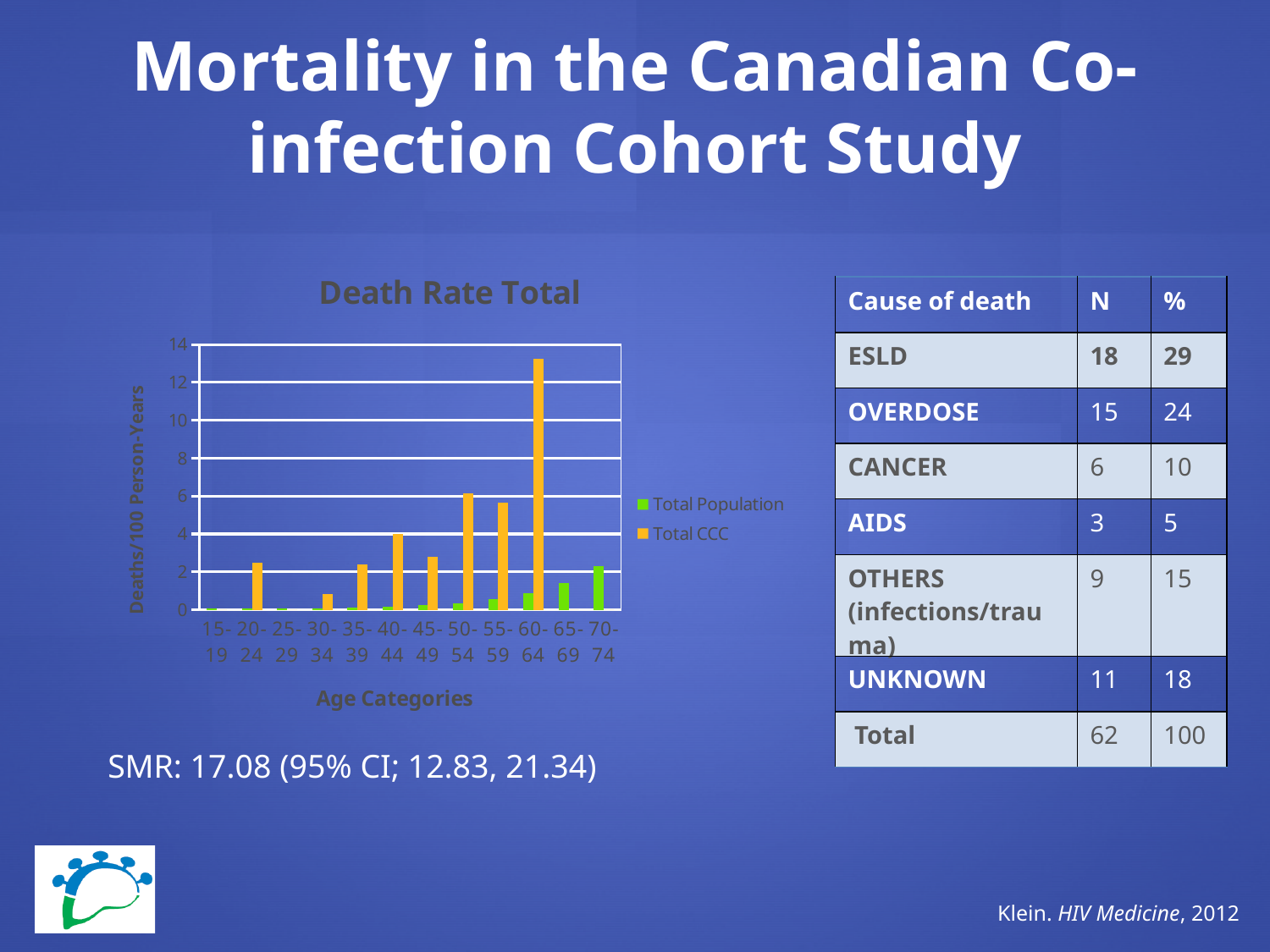
How many age categories are shown on the x axis of the "Death Rate Total" chart? 12 In the "Death Rate Total" chart, which is larger for the 60-64 age category: Total Population or Total CCC? Total CCC What is the y-axis title of the "Death Rate Total" chart? Deaths/100 Person-Years How many series does the legend of the "Death Rate Total" chart list? 2 In the "Death Rate Total" chart, is the Total Population value for 60-64 greater or less than 2? less In the "Death Rate Total" chart, which age category has the larger Total CCC value: 40-44 or 50-54? 50-54 In the "Death Rate Total" chart, is the Total CCC value for 40-44 greater or less than 6? less In the "Death Rate Total" chart, is the Total CCC value for 60-64 greater or less than 12? greater What type of chart is the "Death Rate Total" chart? bar chart In the "Death Rate Total" chart, which age category has the highest Total Population value? 70-74 In the "Death Rate Total" chart, which age category has the highest Total CCC value? 60-64